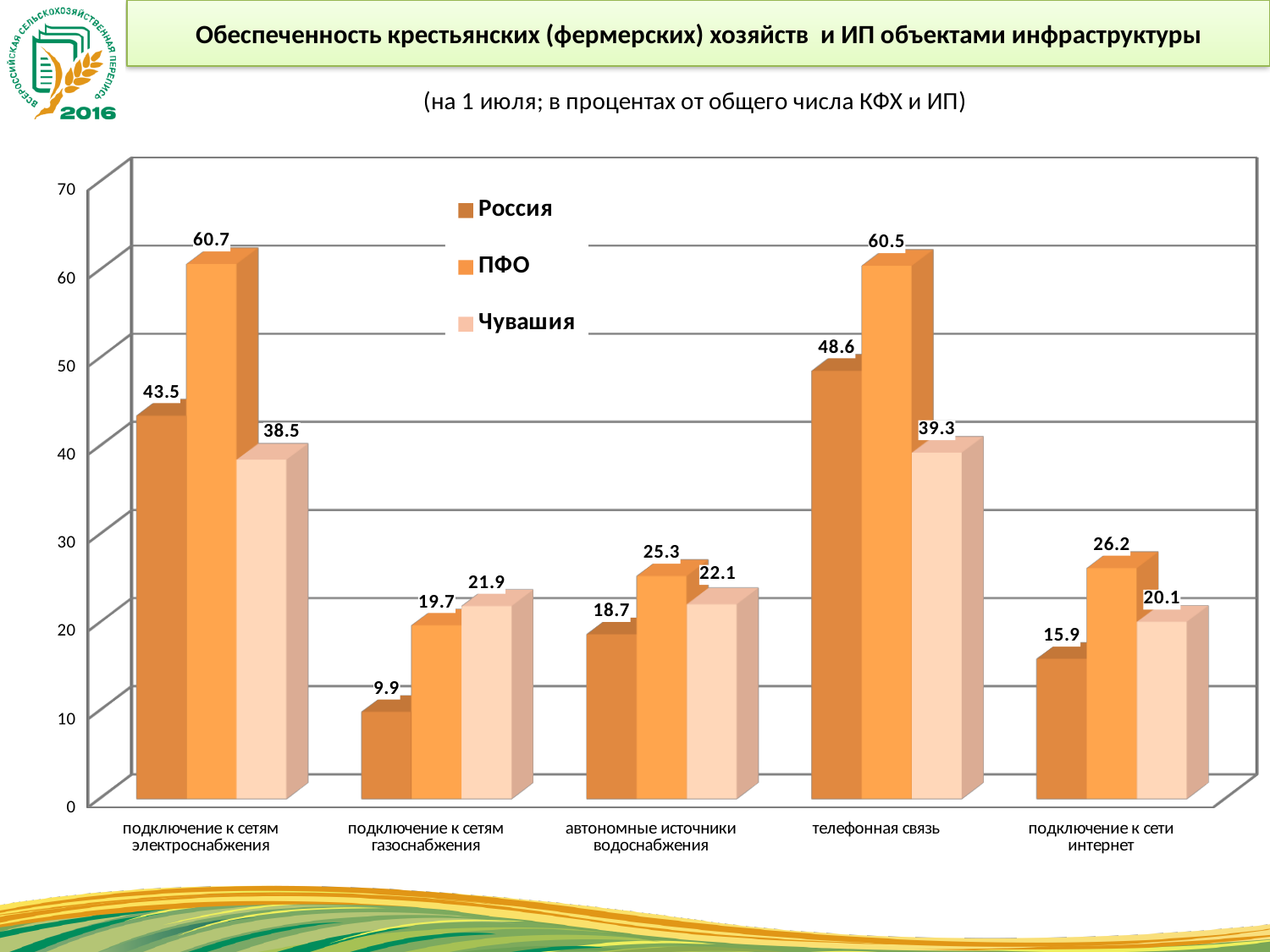
What is the value for Чувашия in the category 'подключение к сети интернет'? 20.1 What kind of chart is shown on the slide? bar chart Which is larger for 'автономные источники водоснабжения': the value for ПФО or the value for Чувашия? ПФО What is the value for Россия in the category 'подключение к сетям электроснабжения'? 43.5 What is the difference between the Россия values for 'телефонная связь' and 'подключение к сети интернет'? 32.7 Is the value for Чувашия in 'телефонная связь' greater or less than 40? less What is the value for ПФО in the category 'телефонная связь'? 60.5 What is the difference between the ПФО and Россия values for 'подключение к сетям электроснабжения'? 17.2 How many series does the legend list? 3 Which category has the highest value for ПФО? подключение к сетям электроснабжения How many categories are shown on the x axis? 5 Which category has the lowest value for Россия? подключение к сетям газоснабжения